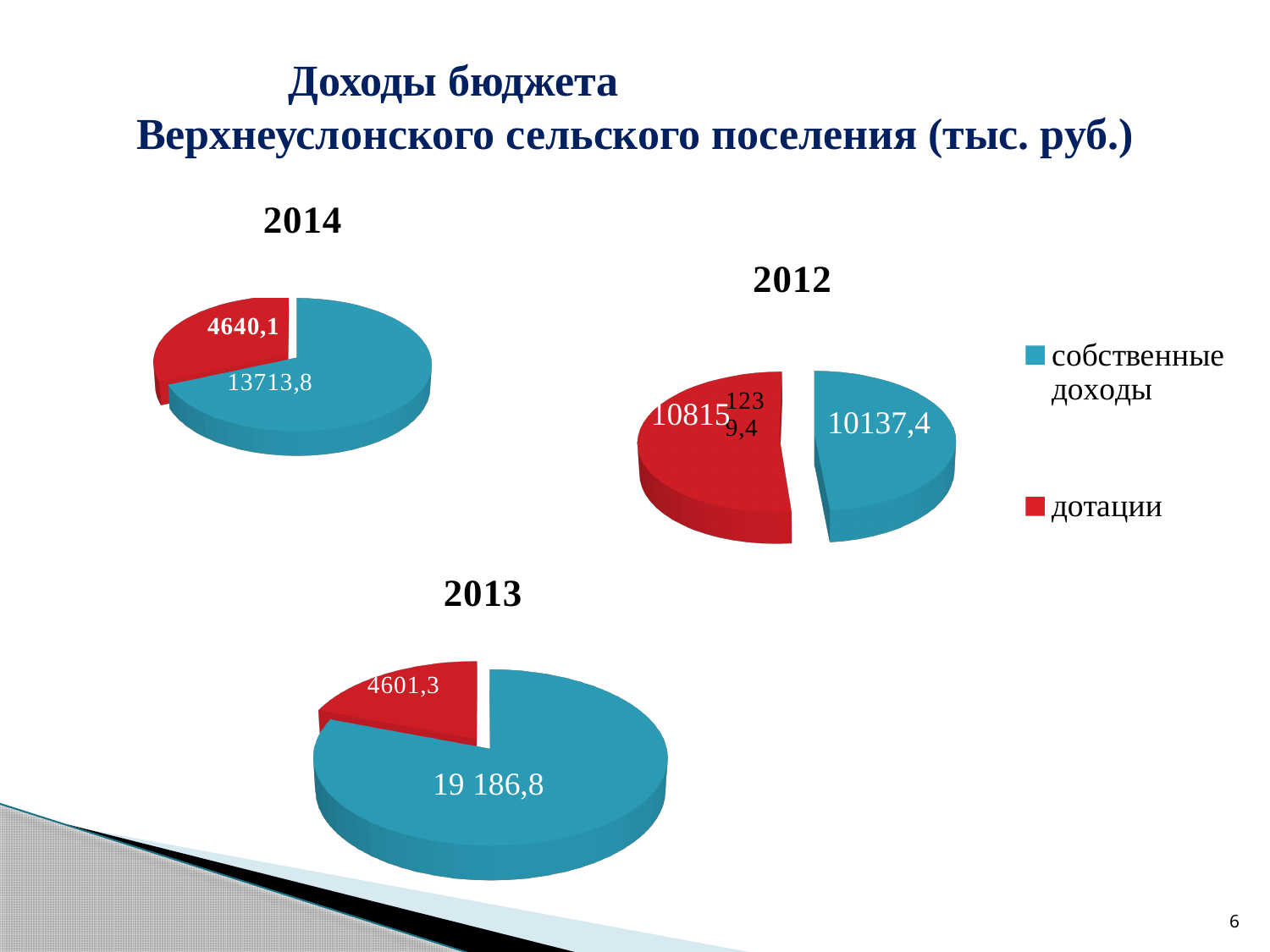
What colour represents дотации in the pie charts? red In the 2013 pie chart, what is the value for дотации? 4601,3 What kind of chart is used for the 2013 data? pie chart In the 2014 pie chart, which is larger: собственные доходы or дотации? собственные доходы In the 2013 pie chart, what is the value for собственные доходы? 19 186,8 In the 2012 pie chart, what is the value for собственные доходы? 10137,4 In the 2013 pie chart, what is the difference between собственные доходы and дотации? 14585,5 How many entries does the legend list? 2 In the 2014 pie chart, what is the difference between собственные доходы and дотации? 9073,7 In the 2014 pie chart, what is the value for собственные доходы? 13713,8 In the 2013 pie chart, which slice is the largest? собственные доходы In the 2014 pie chart, what is the value for дотации? 4640,1